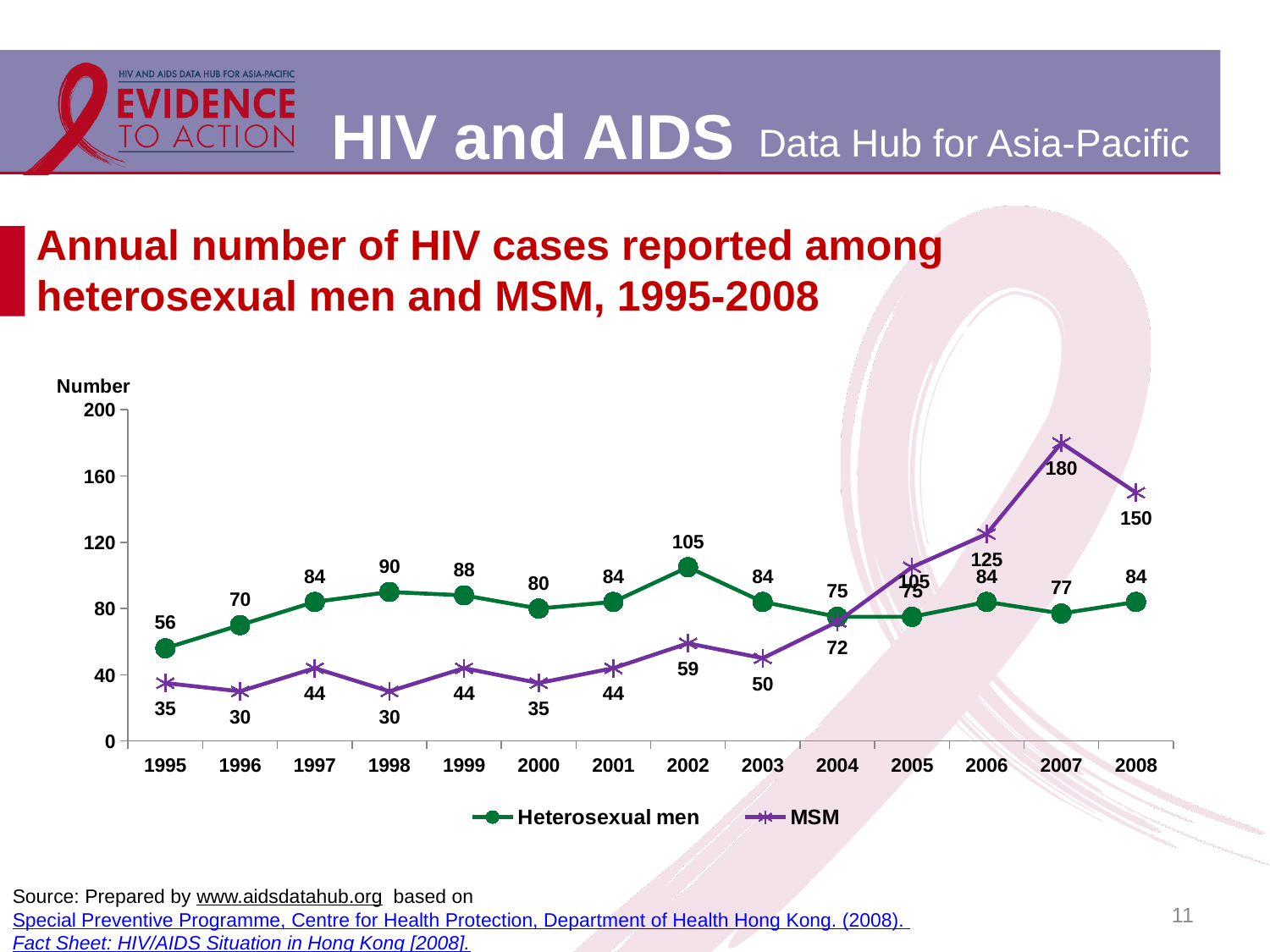
What is the number of HIV cases reported among MSM in 2007? 180 Does the MSM series generally rise or fall from 2003 to 2007? Rise What is the number of HIV cases reported among MSM in 1995? 35 In which year did the MSM series reach its highest value? 2007 In 2003, which series had the larger value, heterosexual men or MSM? Heterosexual men How many years are shown on the x axis? 14 What kind of chart is shown on the slide? Line chart What is the number of HIV cases reported among heterosexual men in 2002? 105 How many series does the legend list? 2 In 2006, which series had the larger value, heterosexual men or MSM? MSM What is the difference between the MSM value and the heterosexual men value in 2008? 66 In which year did the heterosexual men series have its lowest value? 1995